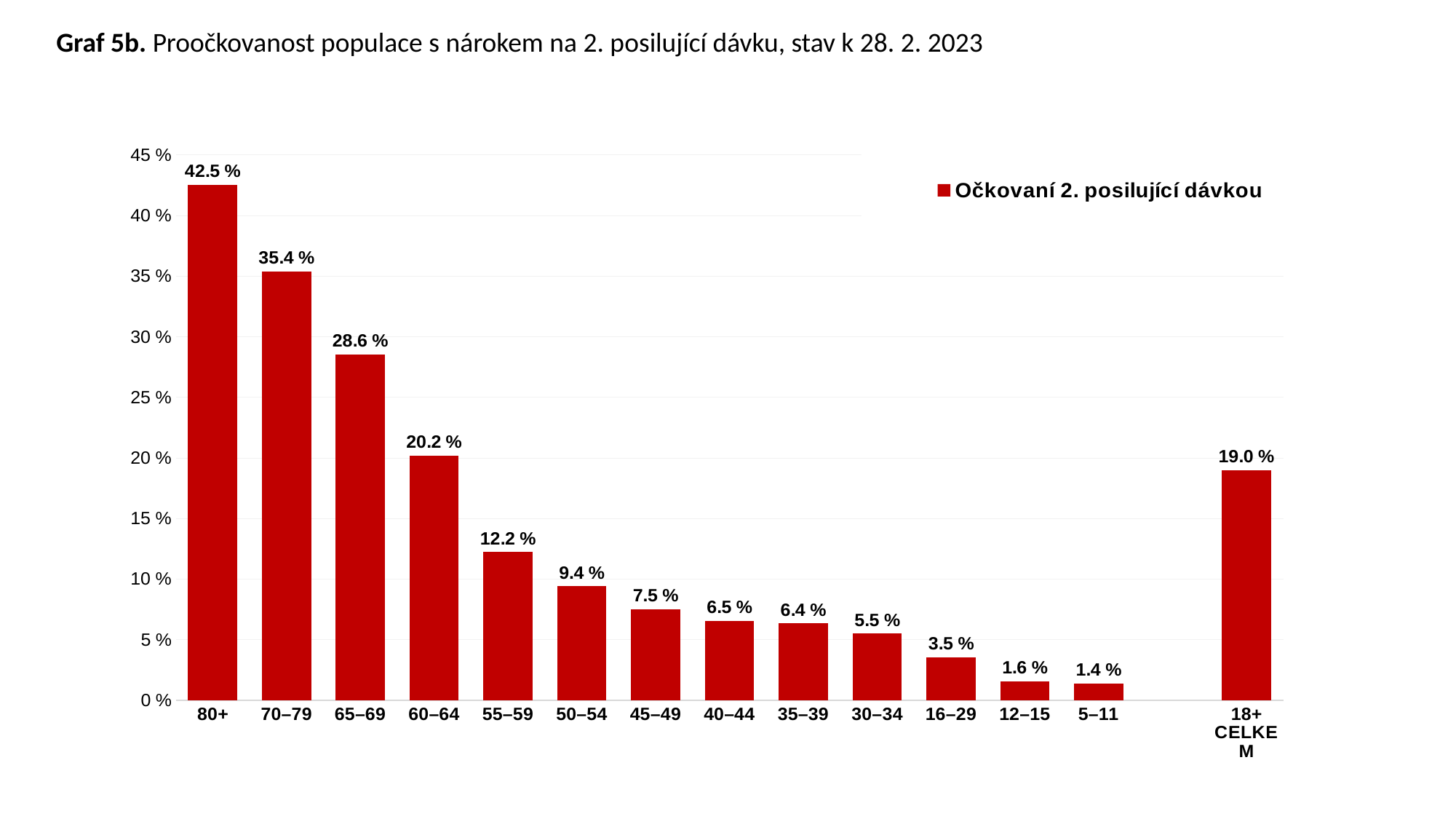
How many series does the legend list? 1 What is the difference between the values for 70–79 and 65–69? 6.8 % What is the value for the 18+ CELKEM category? 19.0 % Is the value for 50–54 greater or less than 10 %? less What kind of chart is shown? bar chart What is the legend entry for the series? Očkovaní 2. posilující dávkou Which age group has the highest value? 80+ How many categories are shown on the x axis? 14 What is the value for the 55–59 age group? 12.2 % Which is larger, the value for 60–64 or the value for 18+ CELKEM? 60–64 Which category has the lowest value? 5–11 What is the value for the 80+ age group? 42.5 %